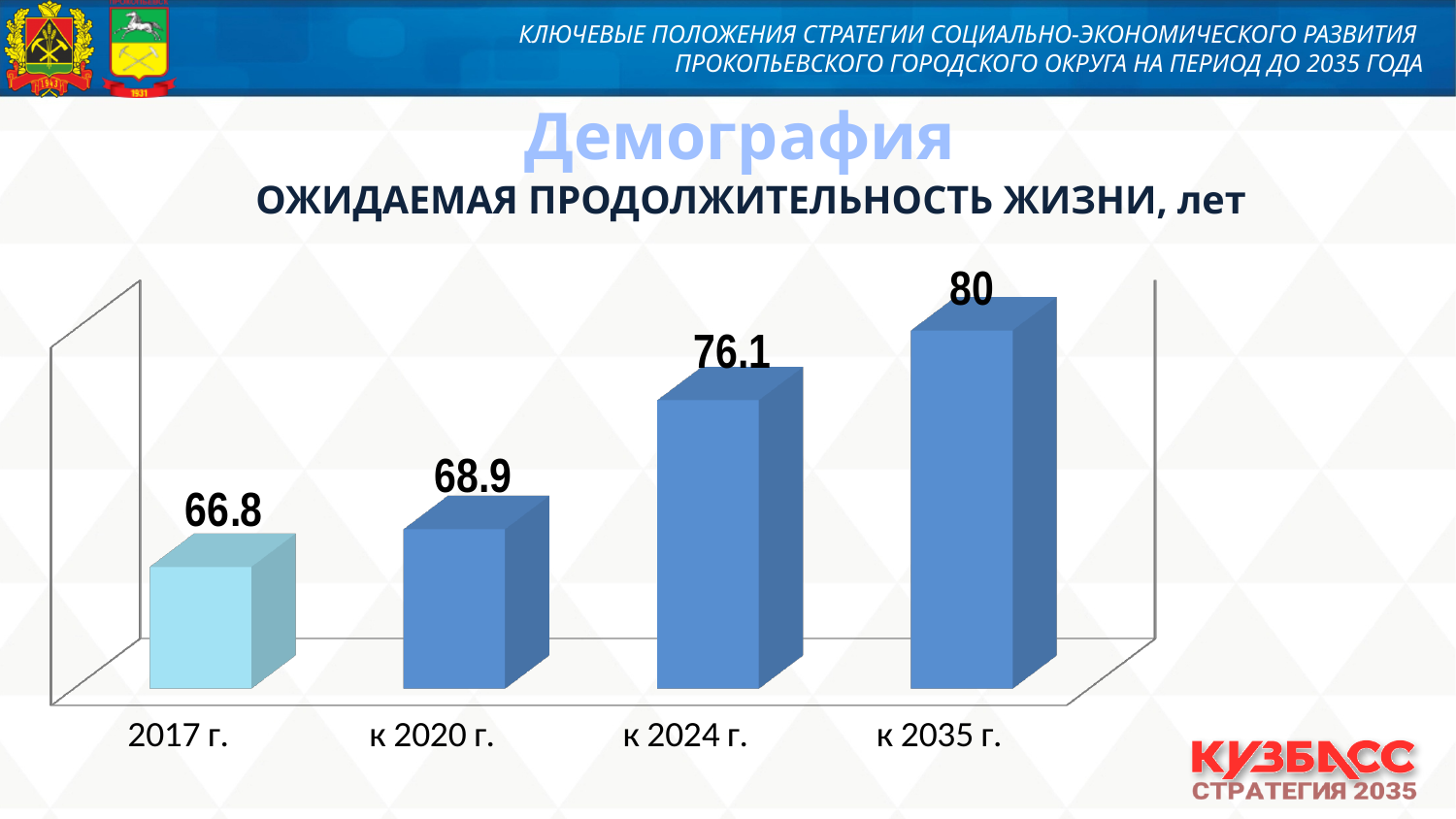
How many categories are shown on the chart? 4 Which category has the lowest value? 2017 г. What value is shown for к 2024 г.? 76.1 What value is shown for к 2020 г.? 68.9 What is the difference between the values for к 2024 г. and к 2020 г.? 7.2 What value is shown for к 2035 г.? 80 Which category has the highest value? к 2035 г. What is the difference between the values for к 2035 г. and 2017 г.? 13.2 Do the values rise or fall from 2017 г. to к 2035 г.? Rise What is the expected life expectancy value shown for 2017 г.? 66.8 Which is larger, the value for к 2020 г. or the value for к 2024 г.? к 2024 г. What kind of chart is shown on the slide? Bar chart